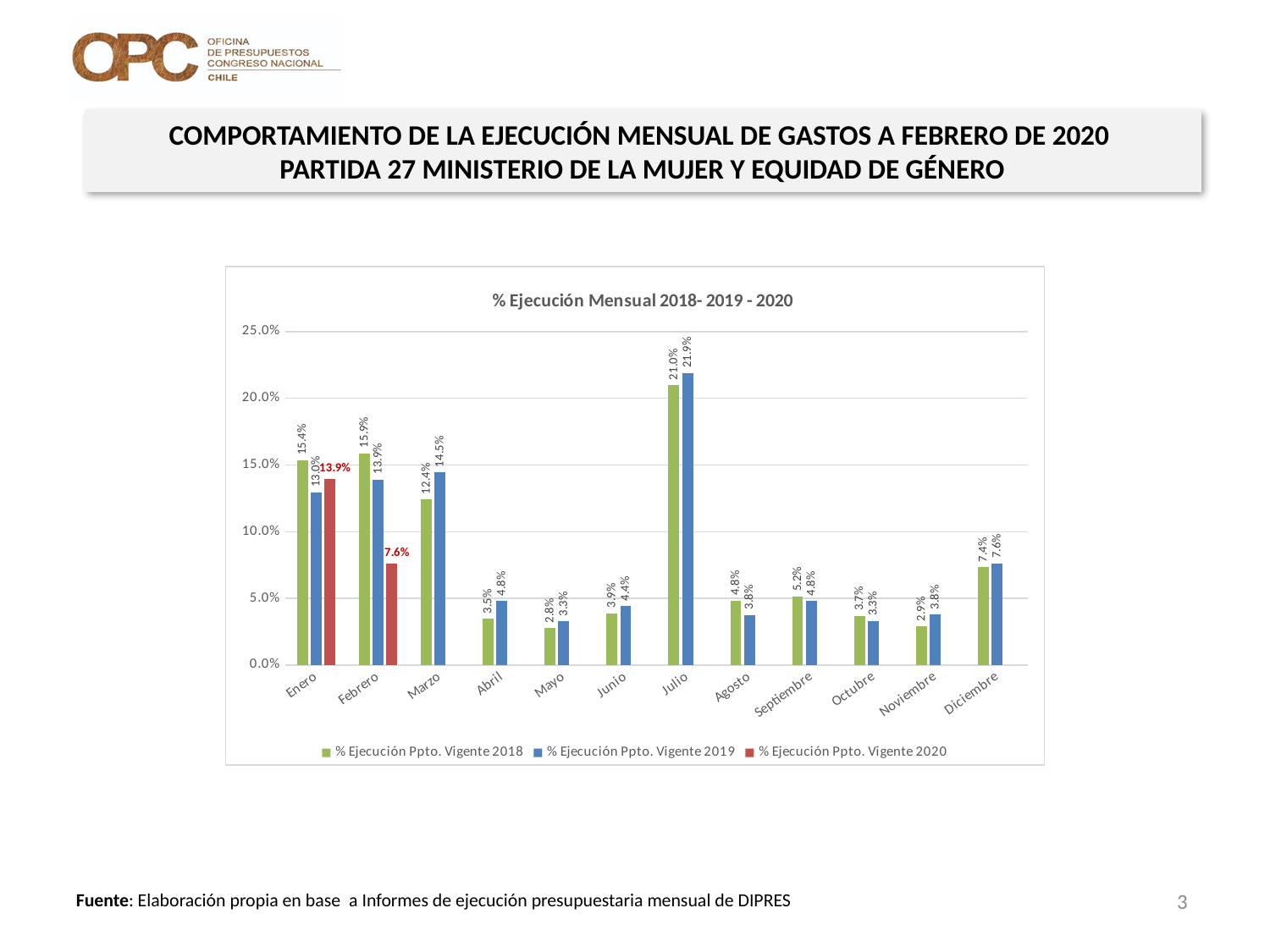
Is the value for Febrero in the 2018 series greater or less than 15.0%? greater What is the value for Marzo in the % Ejecución Ppto. Vigente 2018 series? 12.4% How many series does the legend list? 3 What is the value for Febrero in the % Ejecución Ppto. Vigente 2020 series? 7.6% How many months are shown on the x axis? 12 What is the value for Julio in the % Ejecución Ppto. Vigente 2019 series? 21.9% Which month has the lowest value in the % Ejecución Ppto. Vigente 2018 series? Mayo Which is larger for Agosto: the 2018 value or the 2019 value? 2018 What is the difference between the 2019 and 2018 values for Julio? 0.9% Which month has the highest value in the % Ejecución Ppto. Vigente 2018 series? Julio What is the title of the chart? % Ejecución Mensual 2018- 2019 - 2020 What kind of chart is shown on the slide? Bar chart